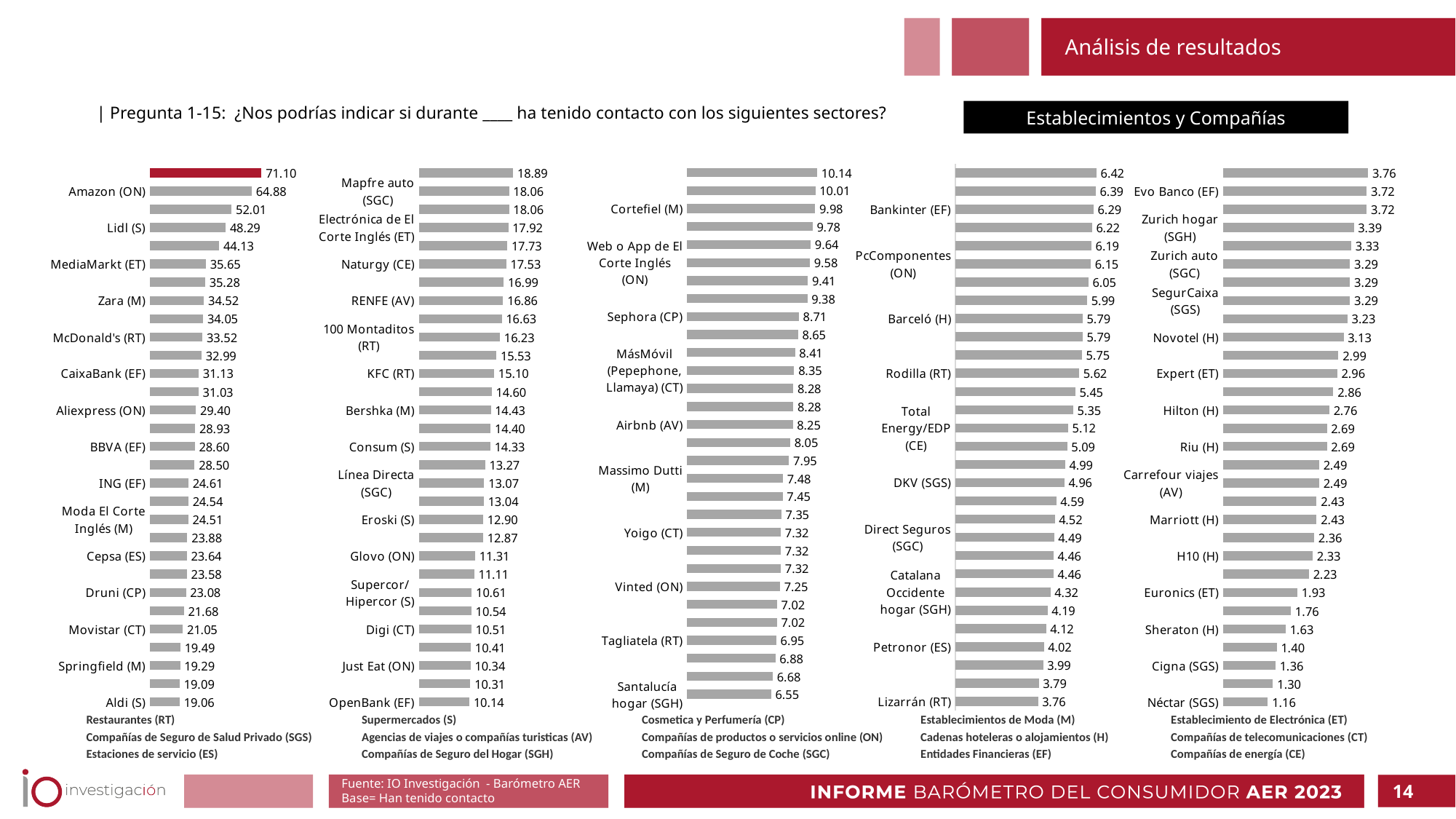
In the second chart from the left, what value is shown for OpenBank (EF)? 10.14 In the leftmost chart, what is the difference between the values for Amazon (ON) and Aldi (S)? 45.82 In the middle chart, which has a larger value, Cortefiel (M) or Yoigo (CT)? Cortefiel (M) In the rightmost chart, what is the difference between the values for Evo Banco (EF) and Hilton (H)? 0.96 What value is shown for Amazon (ON) in the leftmost chart? 64.88 In the middle chart, what value is shown for Sephora (CP)? 8.71 What type of chart is used on this slide? Bar chart In the second chart from the left, what value is shown for Naturgy (CE)? 17.53 In the leftmost chart, what is the value of the top (red) bar? 71.10 In the fourth chart from the left, what value is shown for Bankinter (EF)? 6.29 In the leftmost chart, what value is shown for Lidl (S)? 48.29 In the rightmost chart, what value is shown for Néctar (SGS)? 1.16